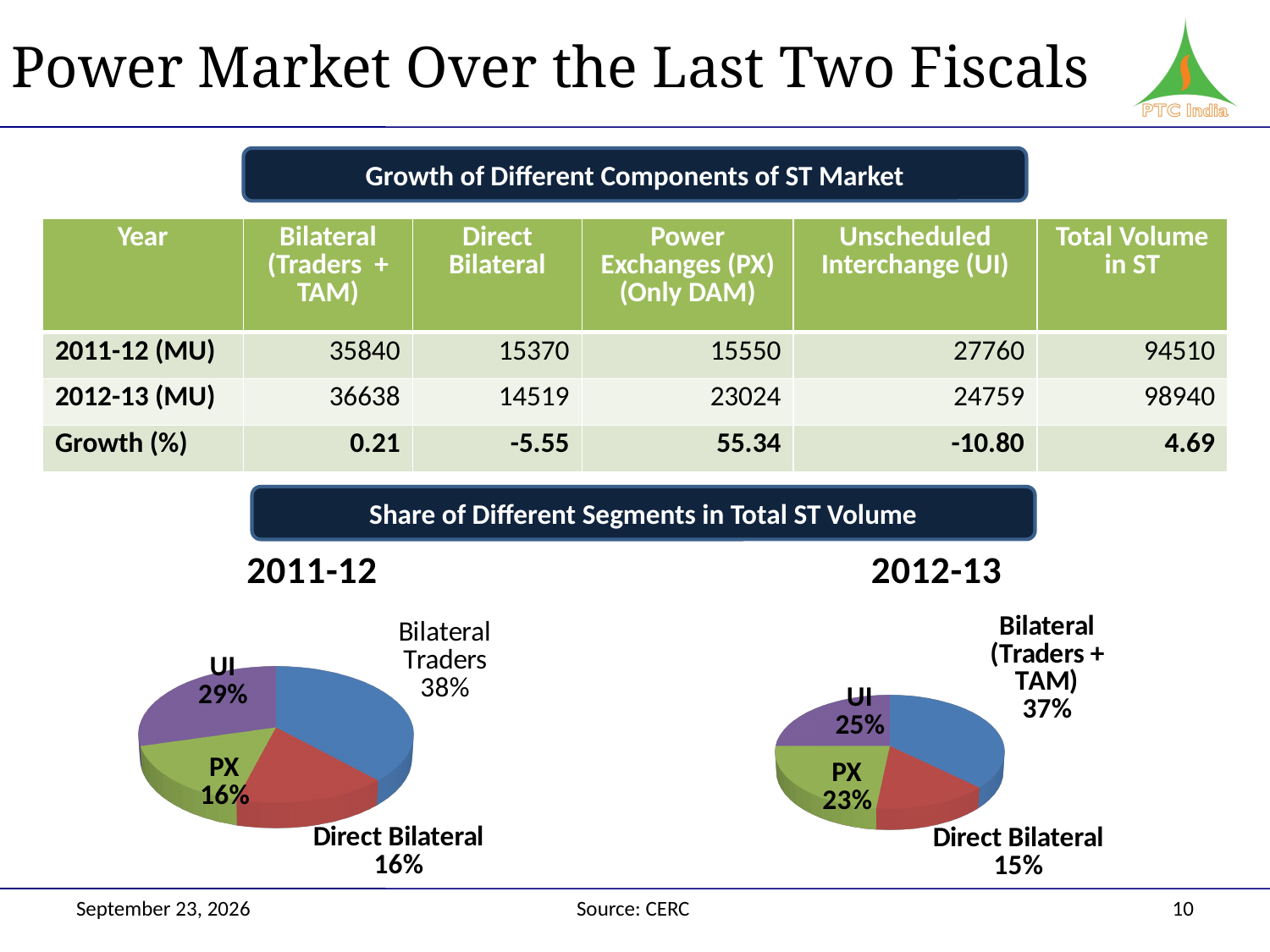
In the 2012-13 pie chart, what share does PX have? 23% Is the PX share larger in the 2011-12 pie chart or the 2012-13 pie chart? 2012-13 In the 2011-12 pie chart, how many segments are shown? 4 In the 2011-12 pie chart, which segment has the largest share? Bilateral Traders In the 2012-13 pie chart, what share does Direct Bilateral have? 15% What is the title of the section containing the two pie charts? Share of Different Segments in Total ST Volume In the 2011-12 pie chart, what is the difference between the UI share and the PX share? 13% In the 2012-13 pie chart, which segment has the largest share? Bilateral (Traders + TAM) In the 2012-13 pie chart, which segment has the smallest share? Direct Bilateral What type of chart is used for the 2012-13 share of segments? Pie chart In the 2011-12 pie chart, what share does Bilateral Traders have? 38%